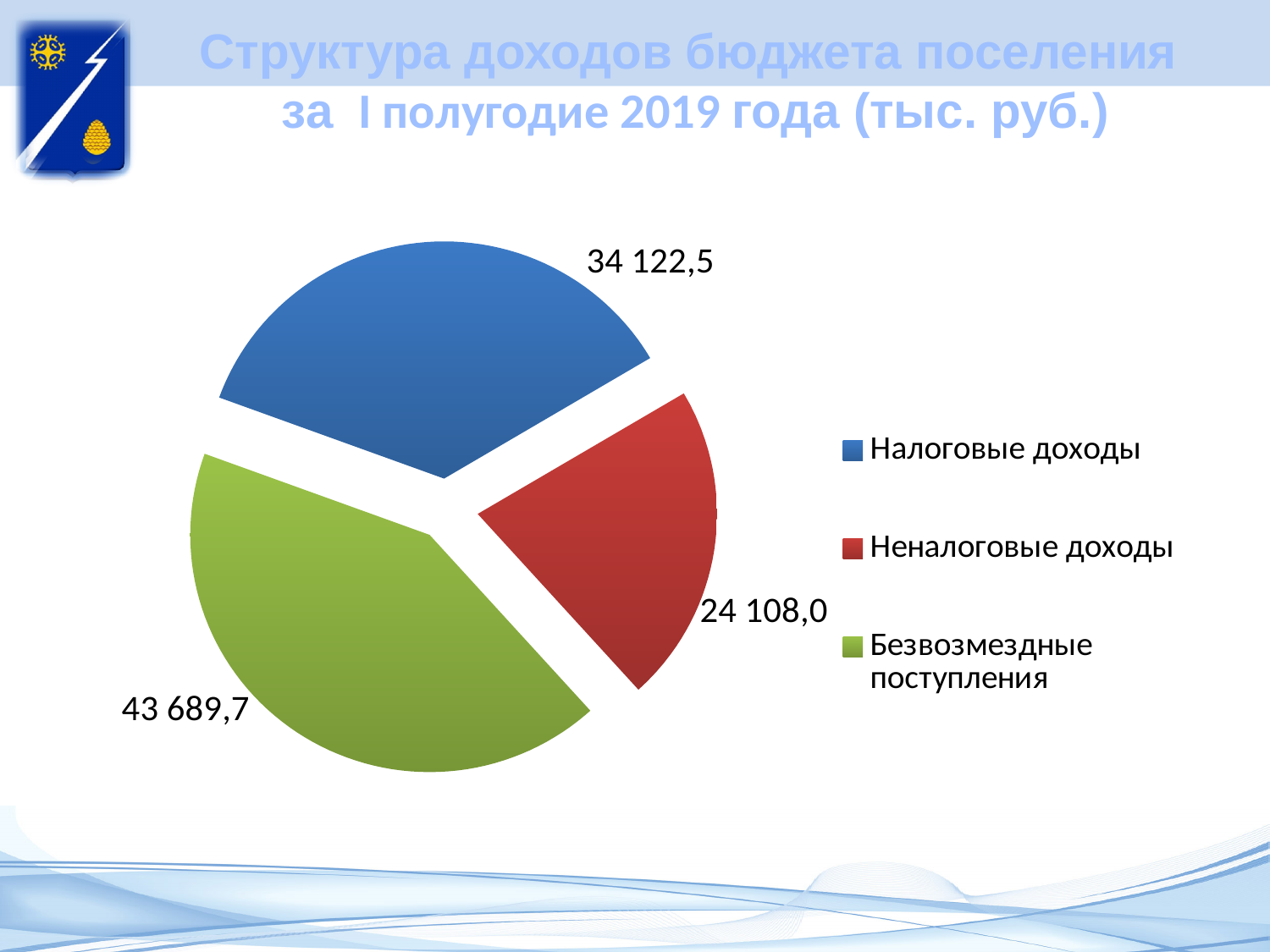
Which is larger, Налоговые доходы or Неналоговые доходы? Налоговые доходы What is the difference between Налоговые доходы and Неналоговые доходы? 10 014,5 What kind of chart is shown on the slide? Pie chart How many entries does the legend list? 3 What is the value for Неналоговые доходы? 24 108,0 Which category has the smallest slice of the pie? Неналоговые доходы What is the value for Безвозмездные поступления? 43 689,7 What colour is the slice for Безвозмездные поступления? Green What is the value for Налоговые доходы? 34 122,5 Which category has the largest slice of the pie? Безвозмездные поступления How many slices does the pie chart have? 3 What is the difference between Безвозмездные поступления and Налоговые доходы? 9 567,2